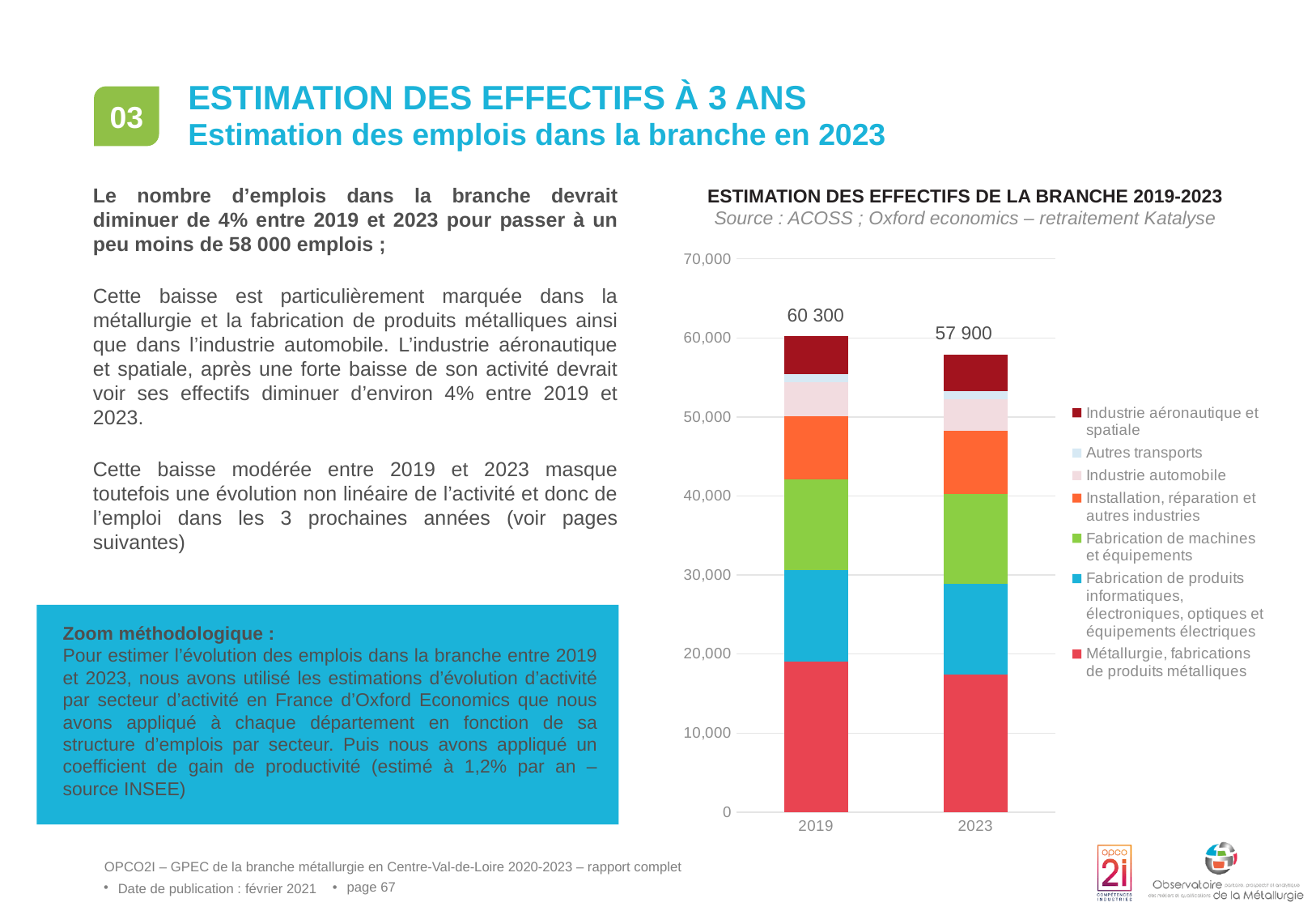
How many years (categories) are plotted on the x axis? 2 How many series does the chart legend list? 7 Which series is shown in dark red at the top of each bar? Industrie aéronautique et spatiale Which year has the higher total, 2019 or 2023? 2019 What type of chart is shown on the slide? Stacked bar chart What is the title of the chart? ESTIMATION DES EFFECTIFS DE LA BRANCHE 2019-2023 Which year has the lowest total? 2023 What is the difference between the 2019 total and the 2023 total? 2 400 Do the total values rise or fall from 2019 to 2023? Fall What is the total value of the 2023 bar? 57 900 Is the value for Métallurgie, fabrications de produits métalliques in 2019 greater or less than 20,000? less What is the total value of the 2019 bar? 60 300